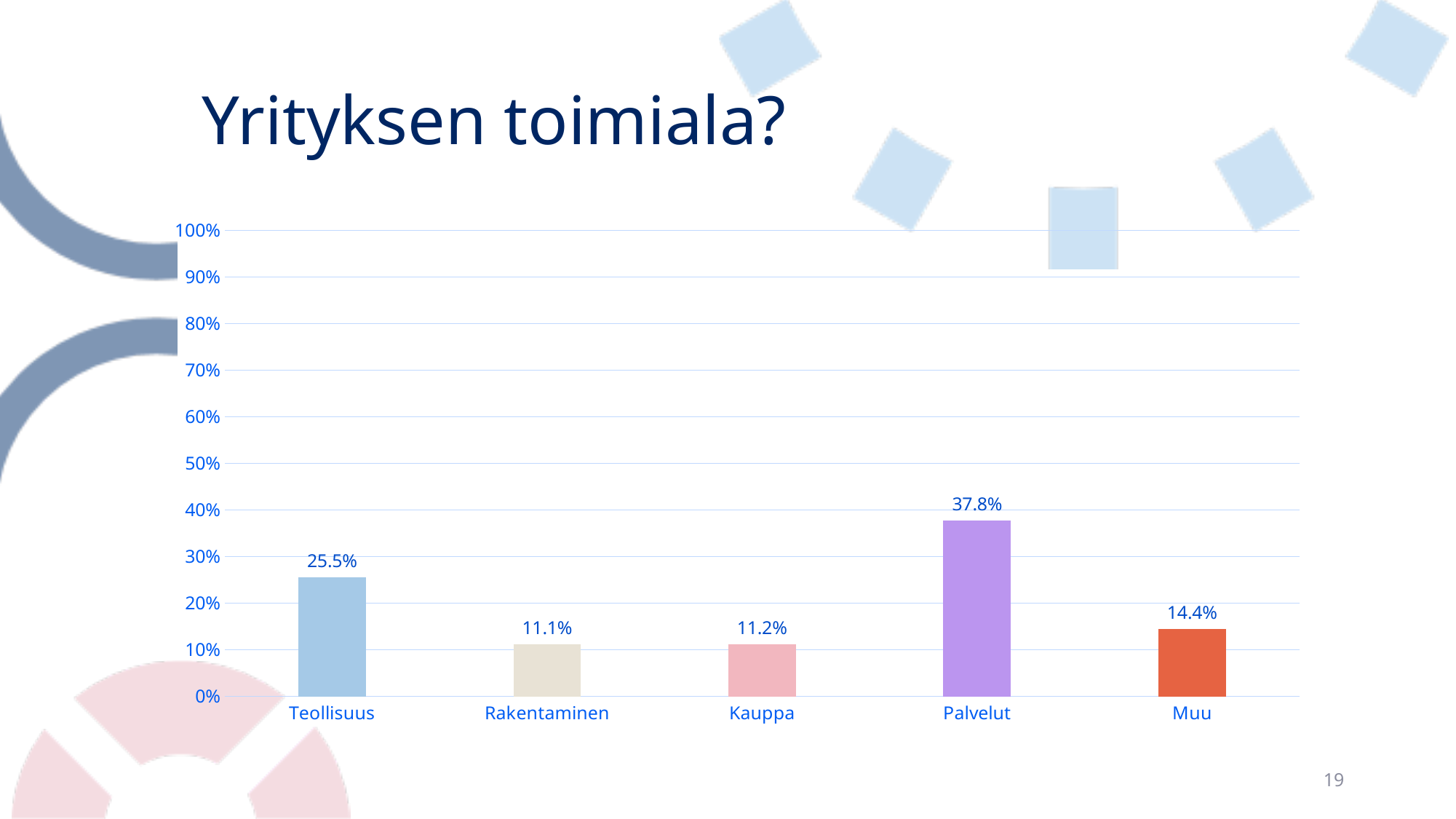
Which category has the highest value? Palvelut How many categories are shown on the x axis? 5 What is the value for Rakentaminen? 11.1% Is the value for Palvelut greater or less than 40%? less What is the title of the slide? Yrityksen toimiala? What is the value for Teollisuus? 25.5% Which is larger, the value for Muu or the value for Kauppa? Muu What is the value for Palvelut? 37.8% What is the value for Muu? 14.4% Which category has the lowest value? Rakentaminen What kind of chart is shown on the slide? bar chart What is the difference between the values for Palvelut and Teollisuus? 12.3%